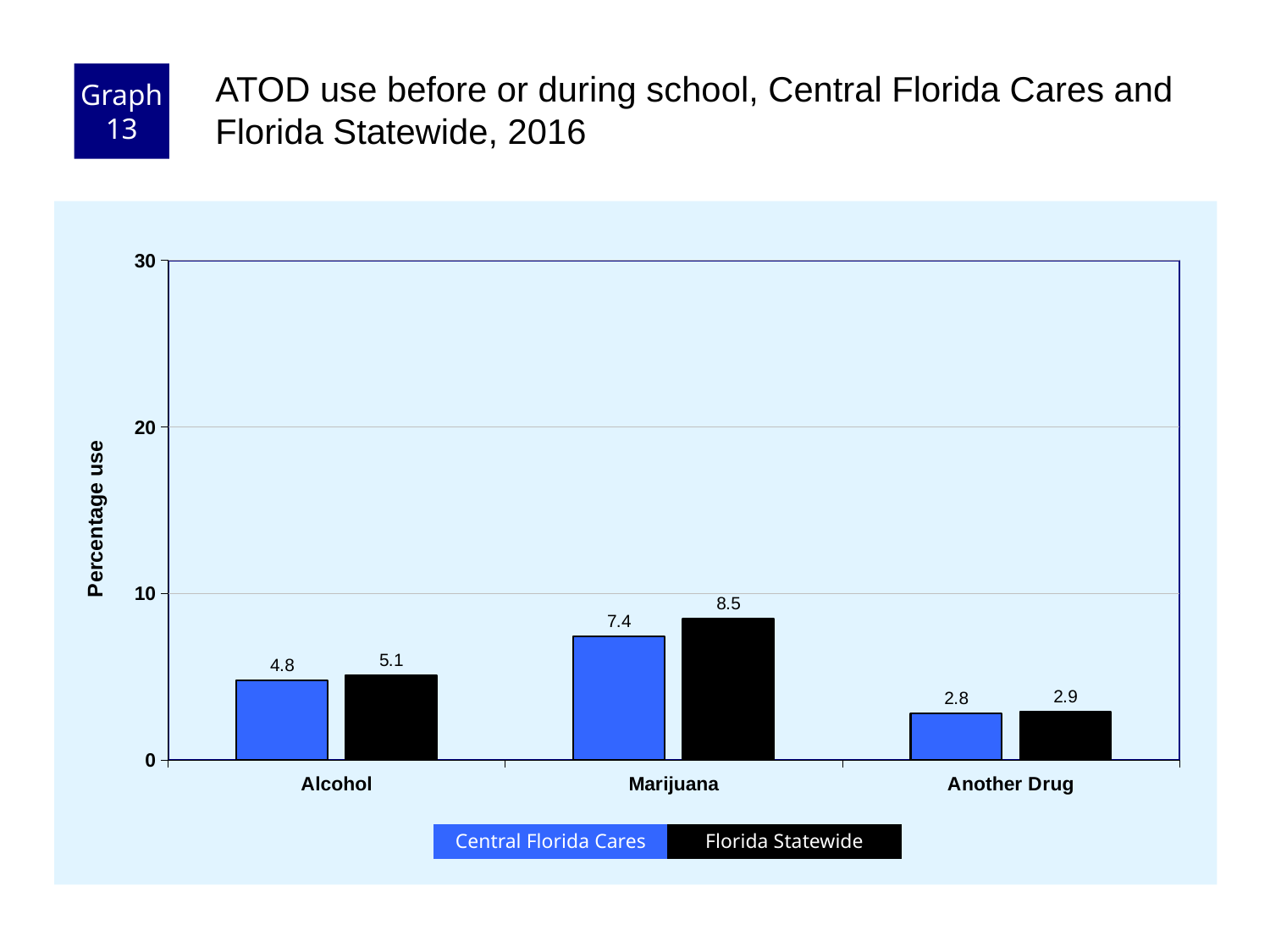
Is the Florida Statewide value for Marijuana greater or less than 10? less Which category has the lowest Florida Statewide value? Another Drug What kind of chart is shown on the slide? bar chart What is the difference between the Florida Statewide and Central Florida Cares values for Marijuana? 1.1 Which is larger for Alcohol: the Central Florida Cares value or the Florida Statewide value? Florida Statewide What is the difference between the Central Florida Cares values for Marijuana and Alcohol? 2.6 What is the Central Florida Cares value for Alcohol? 4.8 Which category has the highest Central Florida Cares value? Marijuana How many categories are shown on the x axis? 3 What is the Florida Statewide value for Marijuana? 8.5 How many series does the legend list? 2 What is the Florida Statewide value for Another Drug? 2.9